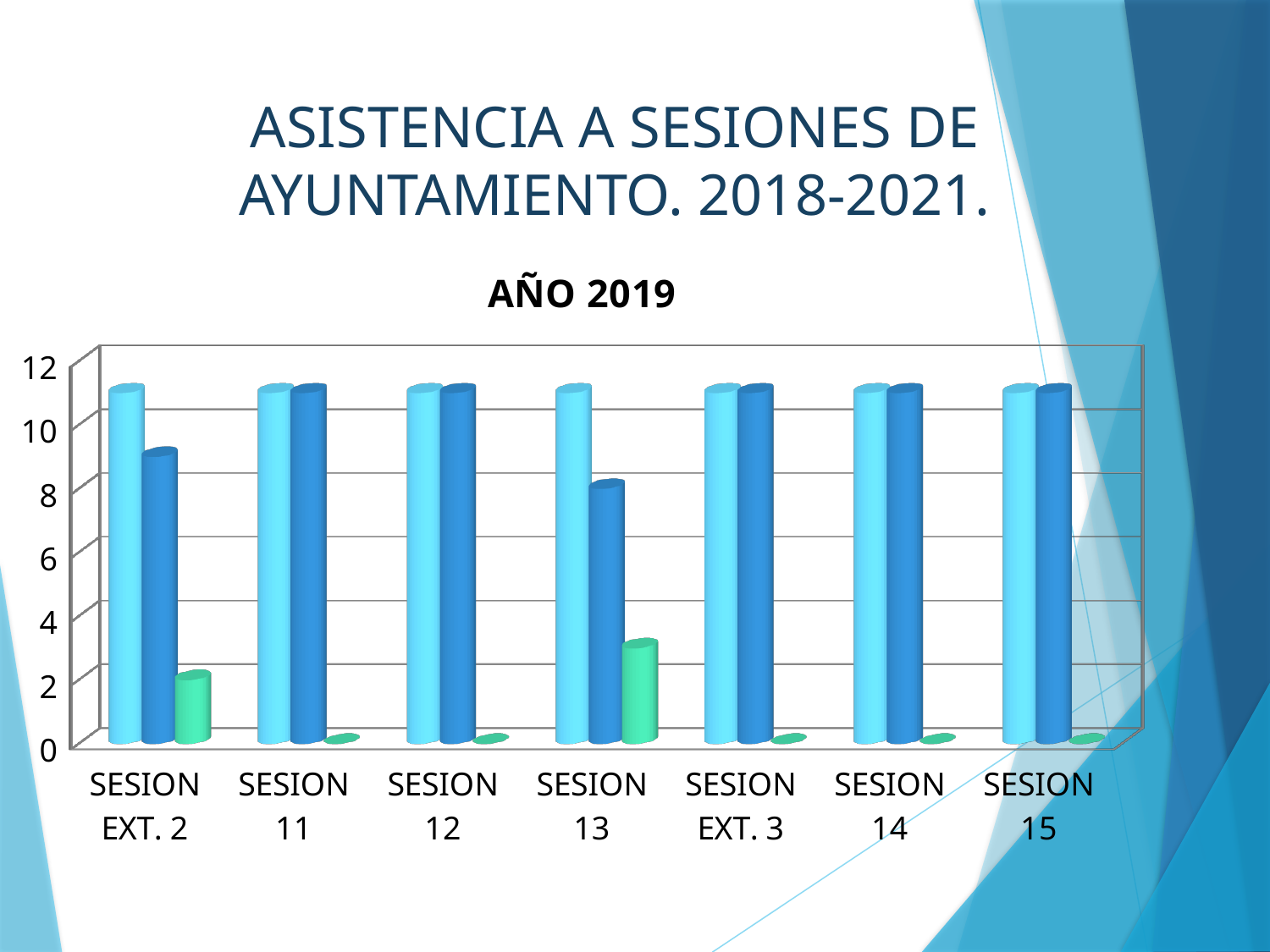
Which session category has the lowest dark blue bar? SESION 13 Is the value of the dark blue bar for SESION EXT. 2 greater or less than 8? greater What is the title of the chart? AÑO 2019 Which session category has the highest green bar? SESION 13 Which is larger, the green bar for SESION 13 or the green bar for SESION EXT. 2? SESION 13 What type of chart is shown on the slide? bar chart How many session categories are shown on the x axis? 7 Is the value of the dark blue bar for SESION 13 greater or less than 10? less Is the value of the green bar for SESION 13 greater or less than 6? less How many bar series are plotted for each session category? 3 Which is larger, the dark blue bar for SESION EXT. 2 or the dark blue bar for SESION 13? SESION EXT. 2